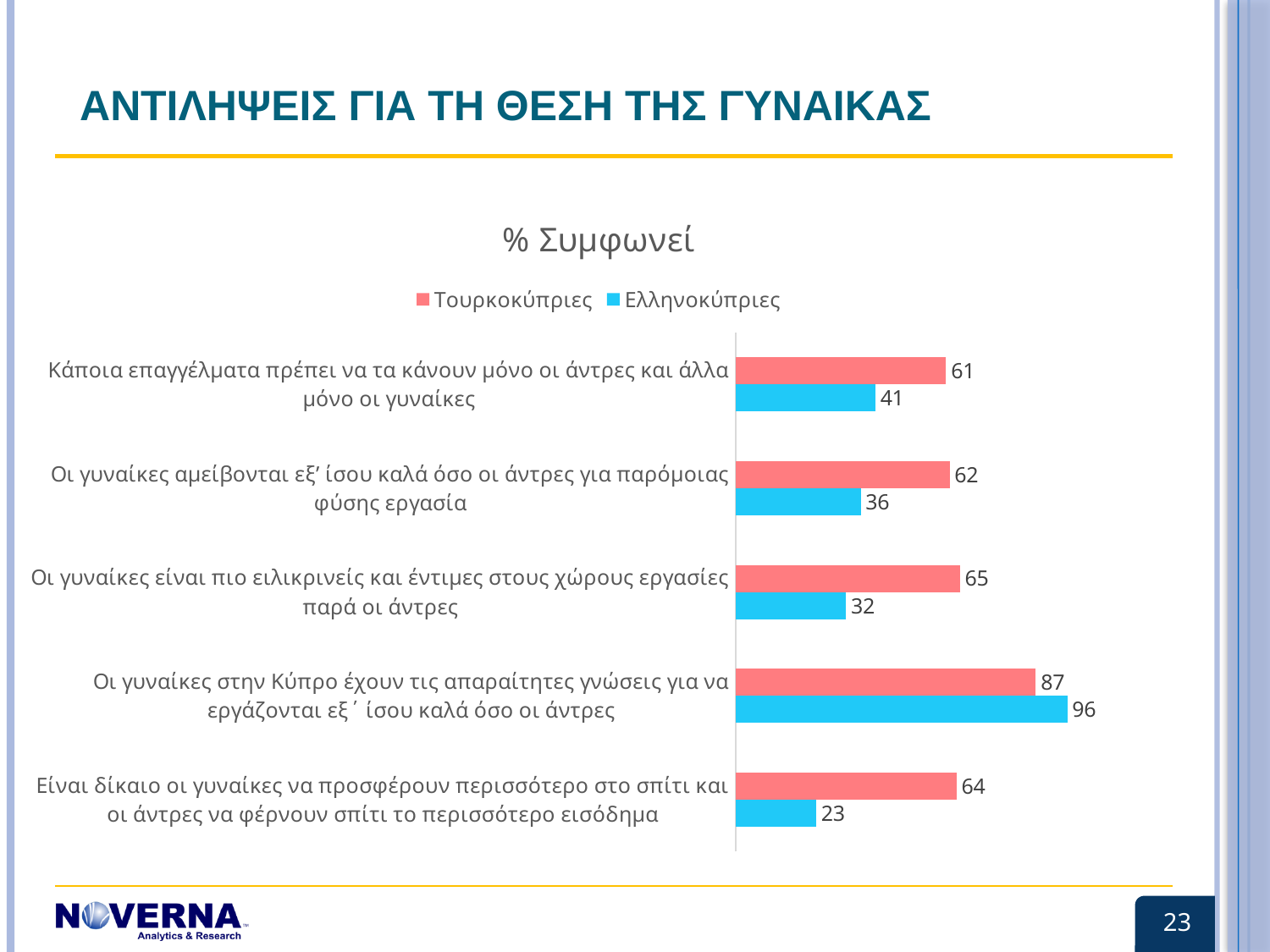
What is the value for Ελληνοκύπριες for the statement 'Οι γυναίκες στην Κύπρο έχουν τις απαραίτητες γνώσεις για να εργάζονται εξ΄ ίσου καλά όσο οι άντρες'? 96 How many series does the legend list? 2 For the statement 'Κάποια επαγγέλματα πρέπει να τα κάνουν μόνο οι άντρες και άλλα μόνο οι γυναίκες', which group has the larger value, Τουρκοκύπριες or Ελληνοκύπριες? Τουρκοκύπριες Which statement has the highest value for Τουρκοκύπριες? Οι γυναίκες στην Κύπρο έχουν τις απαραίτητες γνώσεις για να εργάζονται εξ΄ ίσου καλά όσο οι άντρες What type of chart is shown on the slide? bar chart What is the title shown above the chart? % Συμφωνεί What is the value for Ελληνοκύπριες for the statement 'Οι γυναίκες αμείβονται εξ' ίσου καλά όσο οι άντρες για παρόμοιας φύσης εργασία'? 36 What is the value for Τουρκοκύπριες for the statement 'Είναι δίκαιο οι γυναίκες να προσφέρουν περισσότερο στο σπίτι και οι άντρες να φέρνουν σπίτι το περισσότερο εισόδημα'? 64 How many statements (categories) are plotted in the chart? 5 Which statement has the lowest value for Ελληνοκύπριες? Είναι δίκαιο οι γυναίκες να προσφέρουν περισσότερο στο σπίτι και οι άντρες να φέρνουν σπίτι το περισσότερο εισόδημα For which statement is the Ελληνοκύπριες value higher than the Τουρκοκύπριες value? Οι γυναίκες στην Κύπρο έχουν τις απαραίτητες γνώσεις για να εργάζονται εξ΄ ίσου καλά όσο οι άντρες What is the difference between the Τουρκοκύπριες and Ελληνοκύπριες values for the statement 'Οι γυναίκες είναι πιο ειλικρινείς και έντιμες στους χώρους εργασίες παρά οι άντρες'? 33